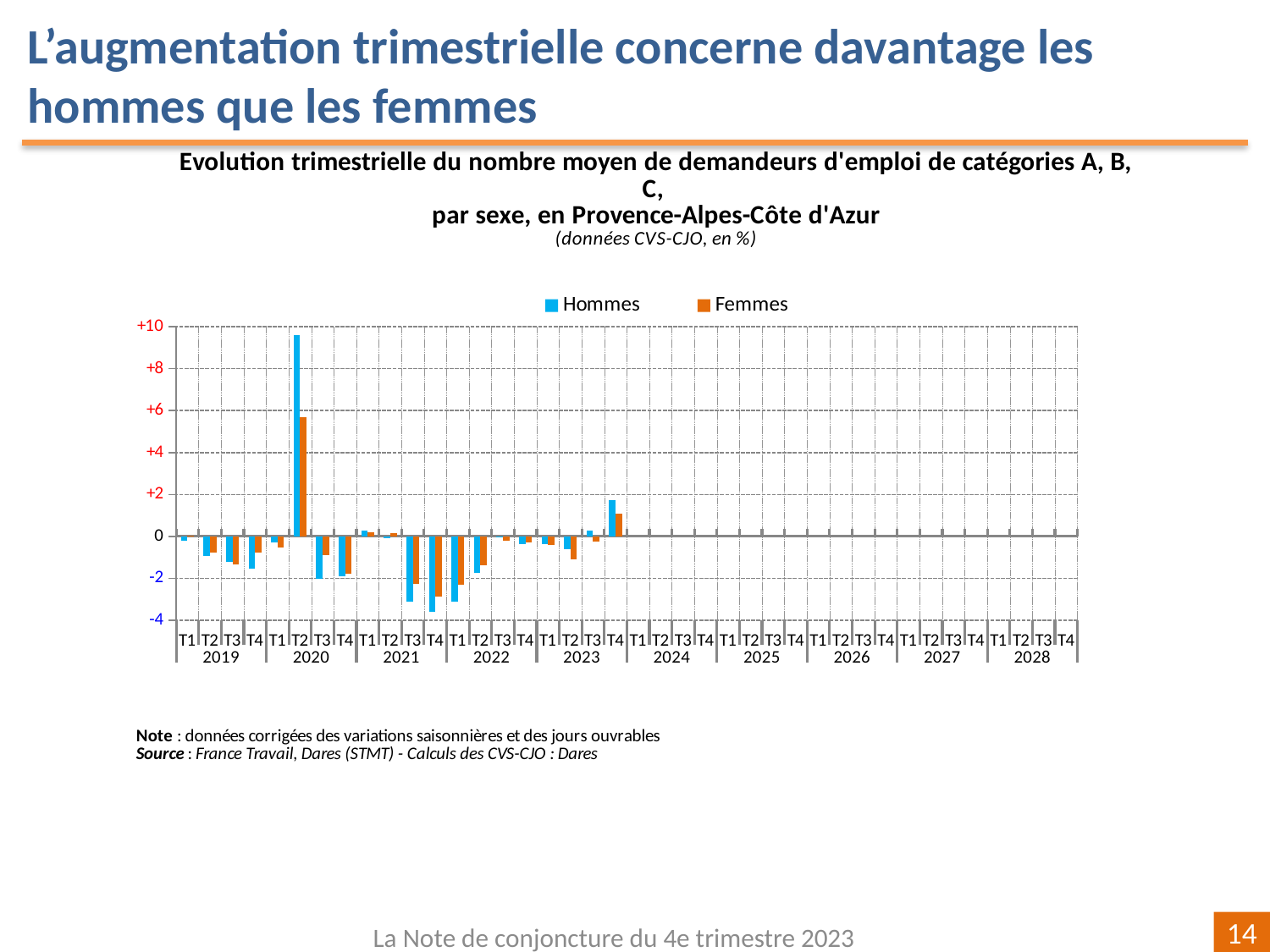
In which quarter does the Hommes series reach its highest value? T2 2020 Is the Hommes value for T2 2020 greater or less than +8? greater How many years are labelled along the x axis? 10 How many series does the legend list? 2 Is the Hommes value for T4 2021 greater or less than -2? less Which colour represents the Femmes series? orange In T4 2023, which series has the larger value, Hommes or Femmes? Hommes Is the Hommes value for T4 2023 greater or less than +2? less What kind of chart is shown on the slide? bar chart In T2 2020, which series has the larger value, Hommes or Femmes? Hommes